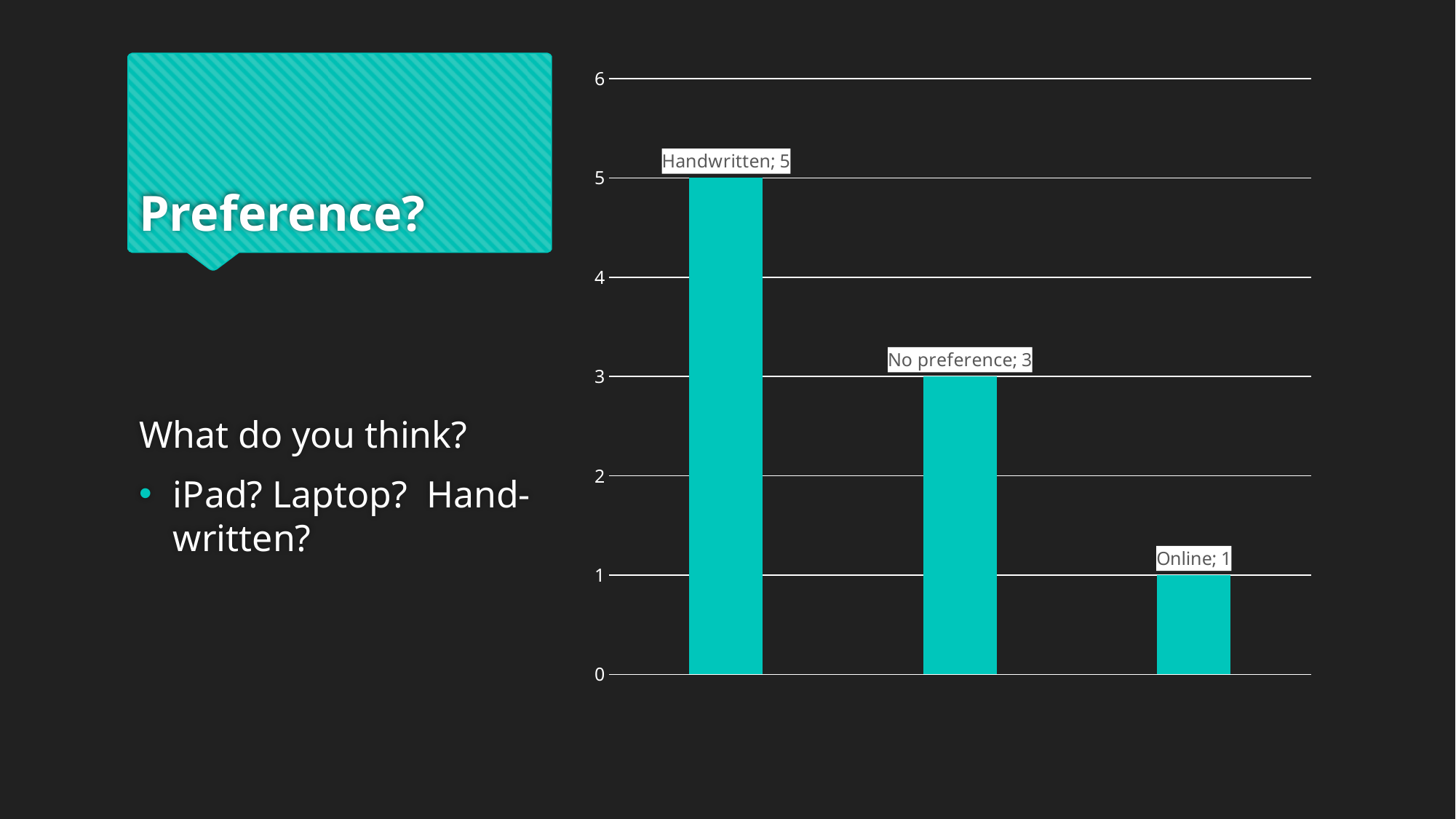
Is the value for Handwritten greater or less than 4? greater How many categories are shown in the chart? 3 What is the difference between the values for No preference and Online? 2 What is the value for No preference? 3 Which category has the highest value? Handwritten What is the difference between the values for Handwritten and No preference? 2 What is the value for Online? 1 Which category has the lowest value? Online What is the value for Handwritten? 5 What kind of chart is shown on the slide? bar chart Which is larger, the value for No preference or the value for Online? No preference Do the values rise or fall from left to right across the categories? fall